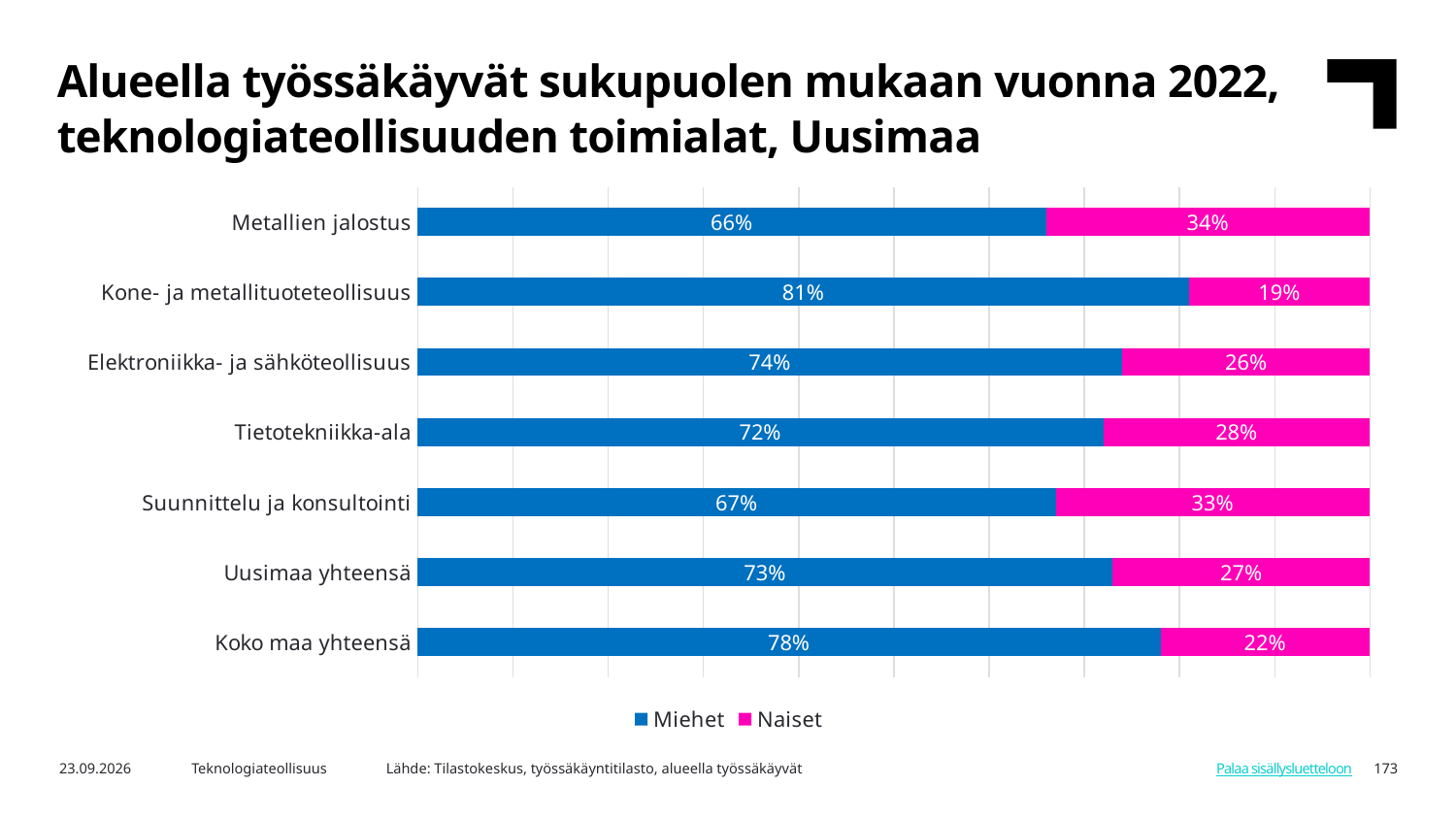
What is the Miehet share for Uusimaa yhteensä? 73% How many series does the legend list? 2 What is the Naiset share for Koko maa yhteensä? 22% Which category has the lowest Miehet share? Metallien jalostus Which is larger: the Naiset share for Suunnittelu ja konsultointi or the Naiset share for Elektroniikka- ja sähköteollisuus? Suunnittelu ja konsultointi What kind of chart is shown on the slide? Stacked bar chart Which category has the highest Naiset share? Metallien jalostus What is the difference between the Miehet share and the Naiset share for Tietotekniikka-ala? 44 percentage points What is the Miehet share for Kone- ja metallituoteteollisuus? 81% Which category has the highest Miehet share? Kone- ja metallituoteteollisuus What is the Naiset share for Metallien jalostus? 34% How many categories are shown on the chart? 7